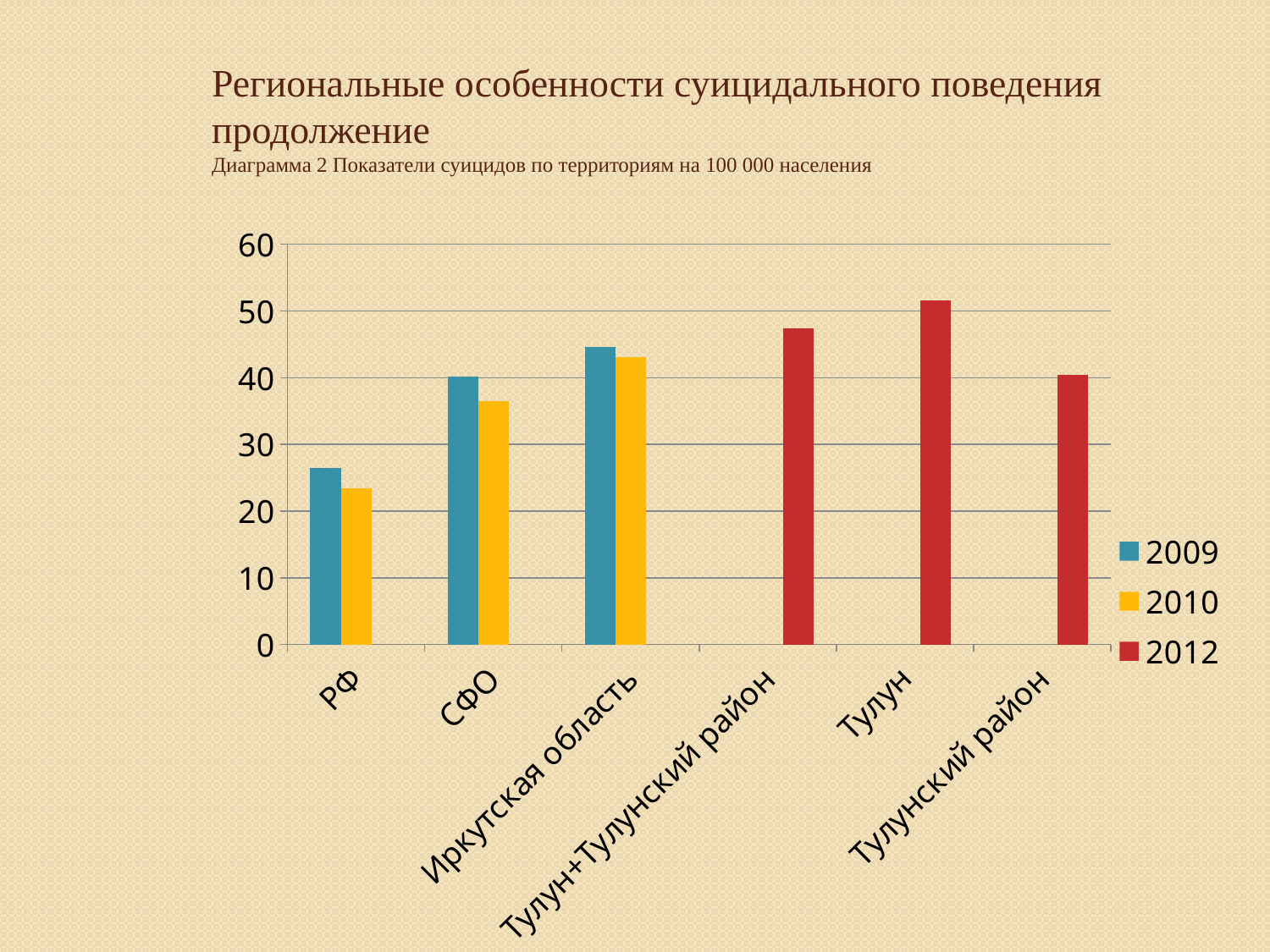
How many series does the legend list? 3 Which bar is the lowest in the chart? РФ, 2010 Among the 2009 bars, which category is highest? Иркутская область For 2012, which is larger: Тулун or Тулунский район? Тулун Is the 2009 value for РФ greater or less than 30? less Is the 2010 value for СФО greater or less than 40? less What kind of chart is shown on the slide? bar chart Which series are listed in the legend? 2009, 2010, 2012 How many categories are shown on the x axis of the chart? 6 Which category has the highest bar in the chart? Тулун For РФ, which is larger: the 2009 value or the 2010 value? 2009 Is the 2012 value for Тулун greater or less than 50? greater